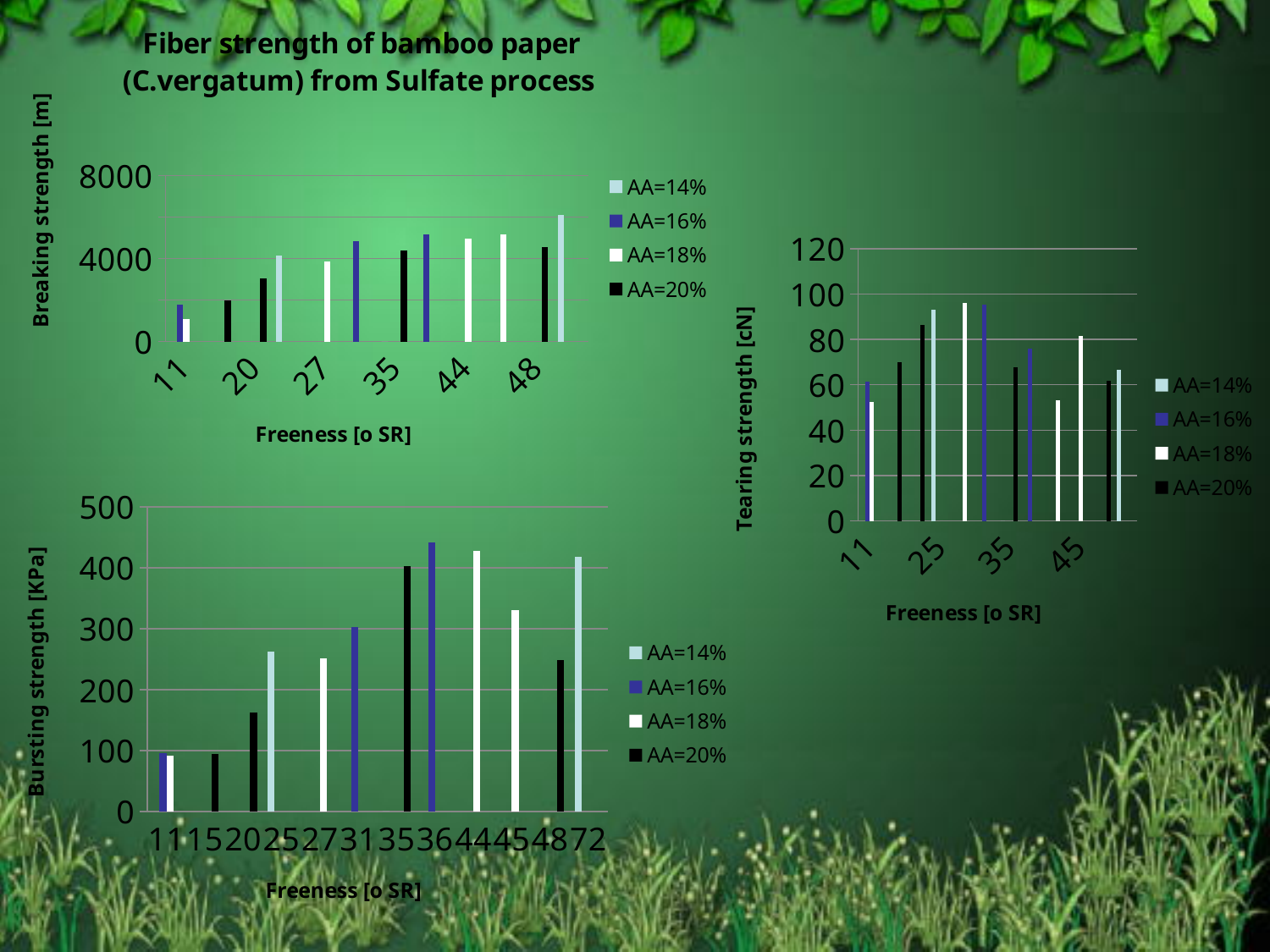
In the Bursting strength chart, which is larger, the bar for freeness 36 or the bar for freeness 20? 36 In the Bursting strength chart, is the value for freeness 25 greater or less than 200? greater In the Bursting strength chart, is the value for freeness 20 greater or less than 200? less What is the highest value shown on the y axis of the Tearing strength chart? 120 In the Tearing strength chart, is the AA=16% bar at freeness 11 greater or less than 40? greater In the Bursting strength chart, which freeness category has the tallest bar? 36 What kind of chart is the Bursting strength chart at the bottom left of the slide? bar chart What is the title of the chart at the top left of the slide? Fiber strength of bamboo paper (C.vergatum) from Sulfate process How many series does the legend of the Tearing strength chart list? 4 How many freeness categories are labelled on the x axis of the Bursting strength chart? 12